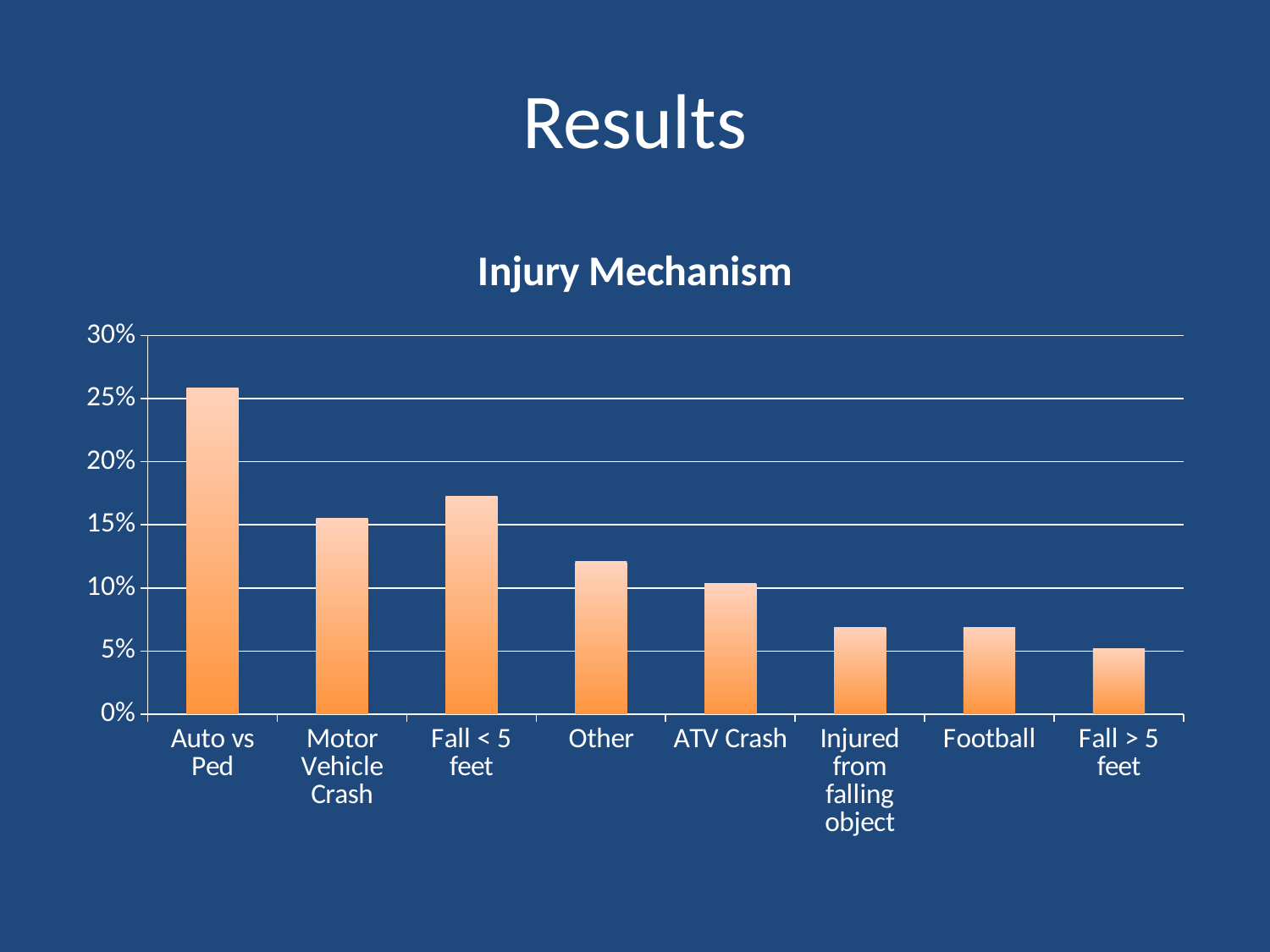
Is the value for Motor Vehicle Crash greater or less than 20%? less Which injury mechanism has the highest percentage? Auto vs Ped Which is larger, the value for Fall < 5 feet or the value for Motor Vehicle Crash? Fall < 5 feet Do the values generally rise or fall moving from left to right across the categories? fall What type of chart is shown on the slide? bar chart Is the value for Fall > 5 feet greater or less than 10%? less Is the value for Fall < 5 feet greater or less than 15%? greater Which injury mechanism has the lowest percentage? Fall > 5 feet What is the title of the chart? Injury Mechanism How many injury mechanism categories are shown in the chart? 8 Which is larger, the value for Other or the value for Fall > 5 feet? Other